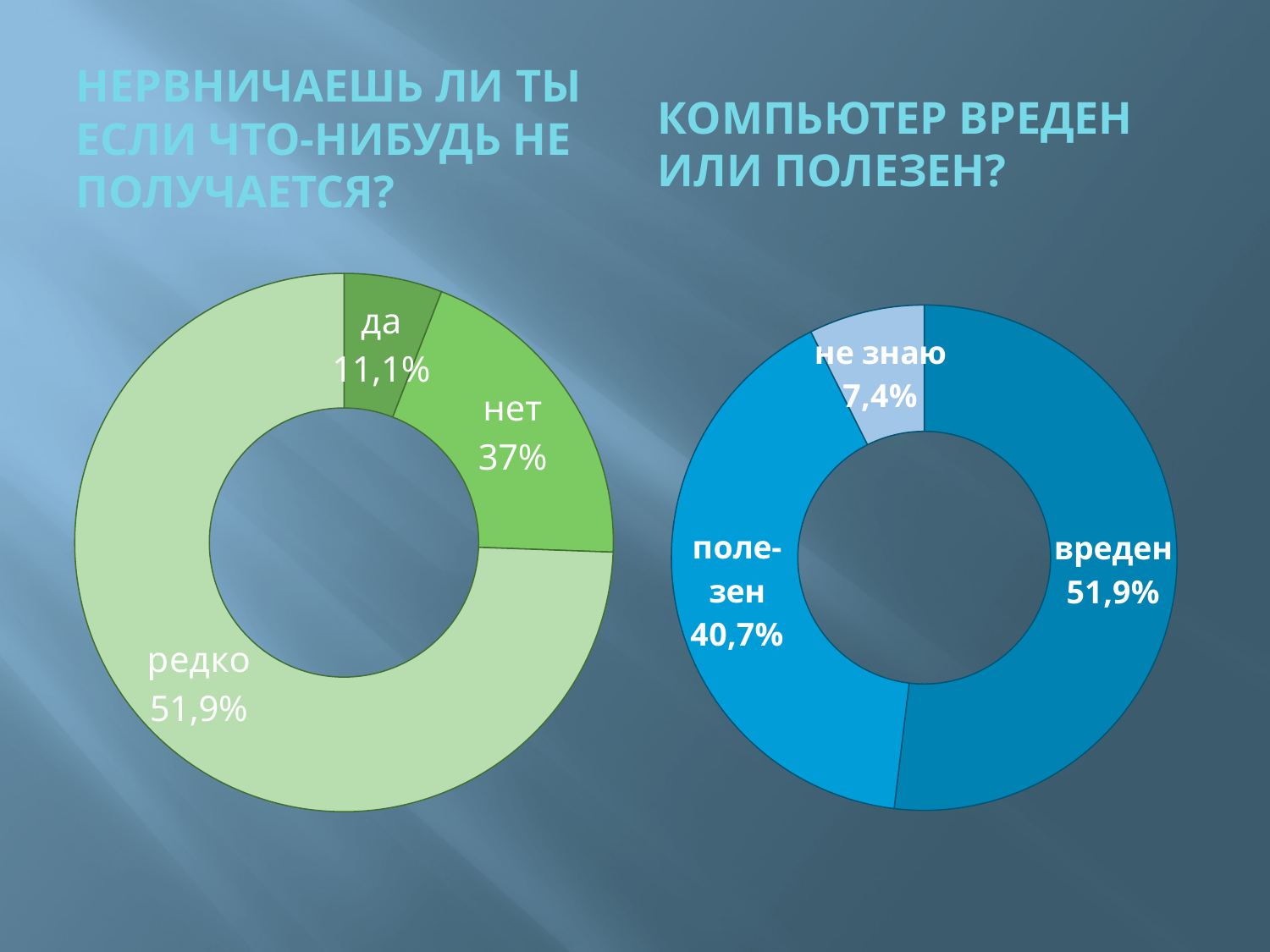
In the left chart ("Нервничаешь ли ты если что-нибудь не получается?"), what percentage is shown for "редко"? 51,9% In the left chart, what percentage is shown for "нет"? 37% In the left chart, which category has the largest share? редко In the left chart, what percentage is shown for "да"? 11,1% What type of chart is used on the left side of the slide? Doughnut (pie) chart How many categories does the right chart show? 3 In the right chart ("Компьютер вреден или полезен?"), what percentage is shown for "вреден"? 51,9% In the left chart, what is the difference between the shares for "нет" and "да"? 25,9% In the left chart, which category has the smallest share? да In the right chart, what percentage is shown for "не знаю"? 7,4% In the right chart, which is larger: the share for "вреден" or for "полезен"? вреден In the right chart, what percentage is shown for "полезен"? 40,7%